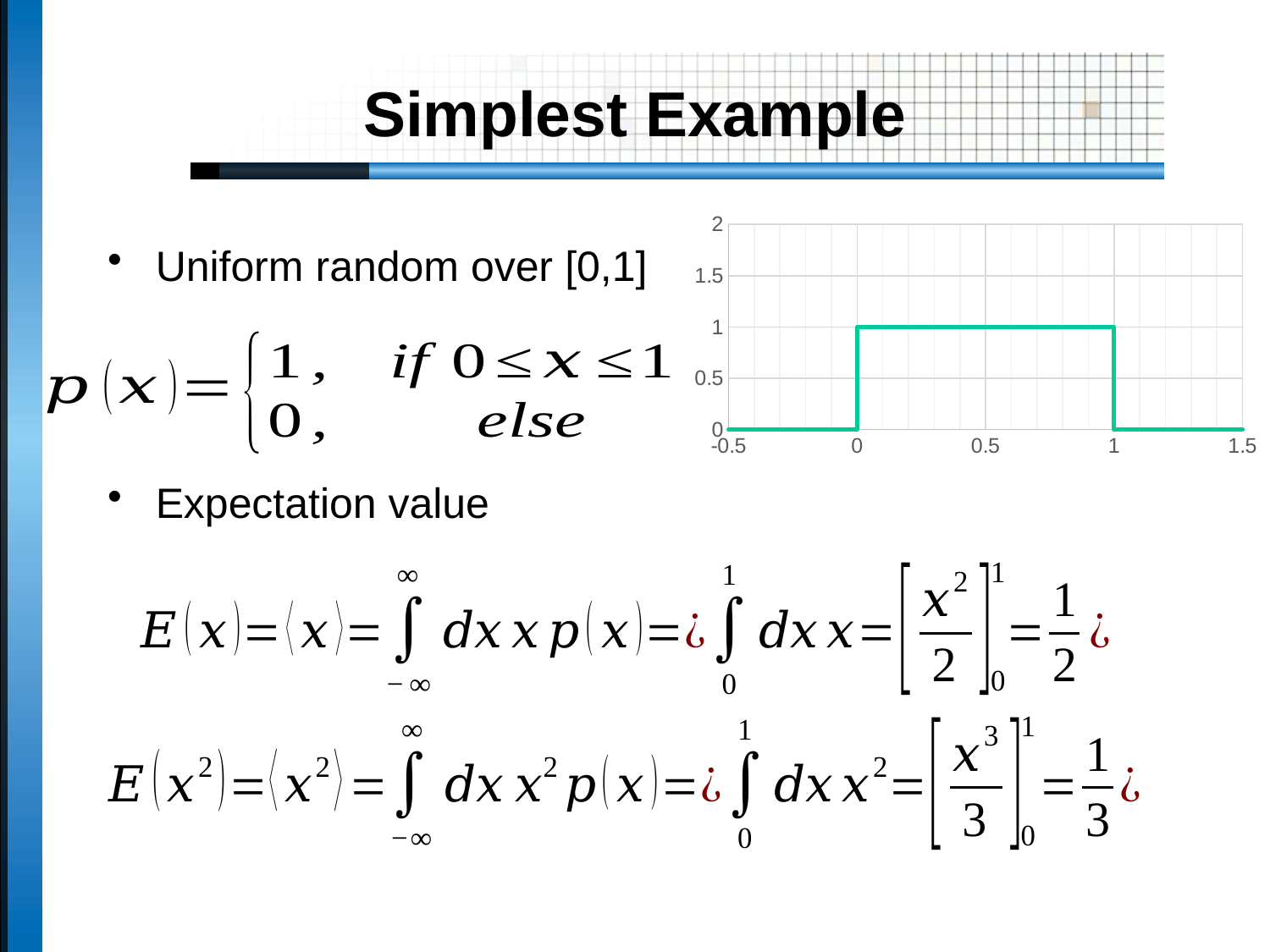
What is the value of the plotted line at x = 0.5? 1 What is the highest value shown on the y axis? 2 What is the value of the plotted line at x = 1.5? 0 Does the plotted line rise or fall as x goes from -0.25 to 0.25? rise What is the difference between the value of the line at x = 0.5 and at x = -0.5? 1 Does the plotted line rise or fall as x goes from 0.75 to 1.25? fall Is the value of the plotted line at x = 0.5 greater or less than 0.5? greater What is the lowest value shown on the x axis? -0.5 Which is larger, the value of the line at x = 0.5 or at x = 1.5? x = 0.5 What kind of chart is shown on the slide? line chart Is the value of the plotted line at x = 1.25 greater or less than 0.5? less What is the value of the plotted line at x = -0.5? 0